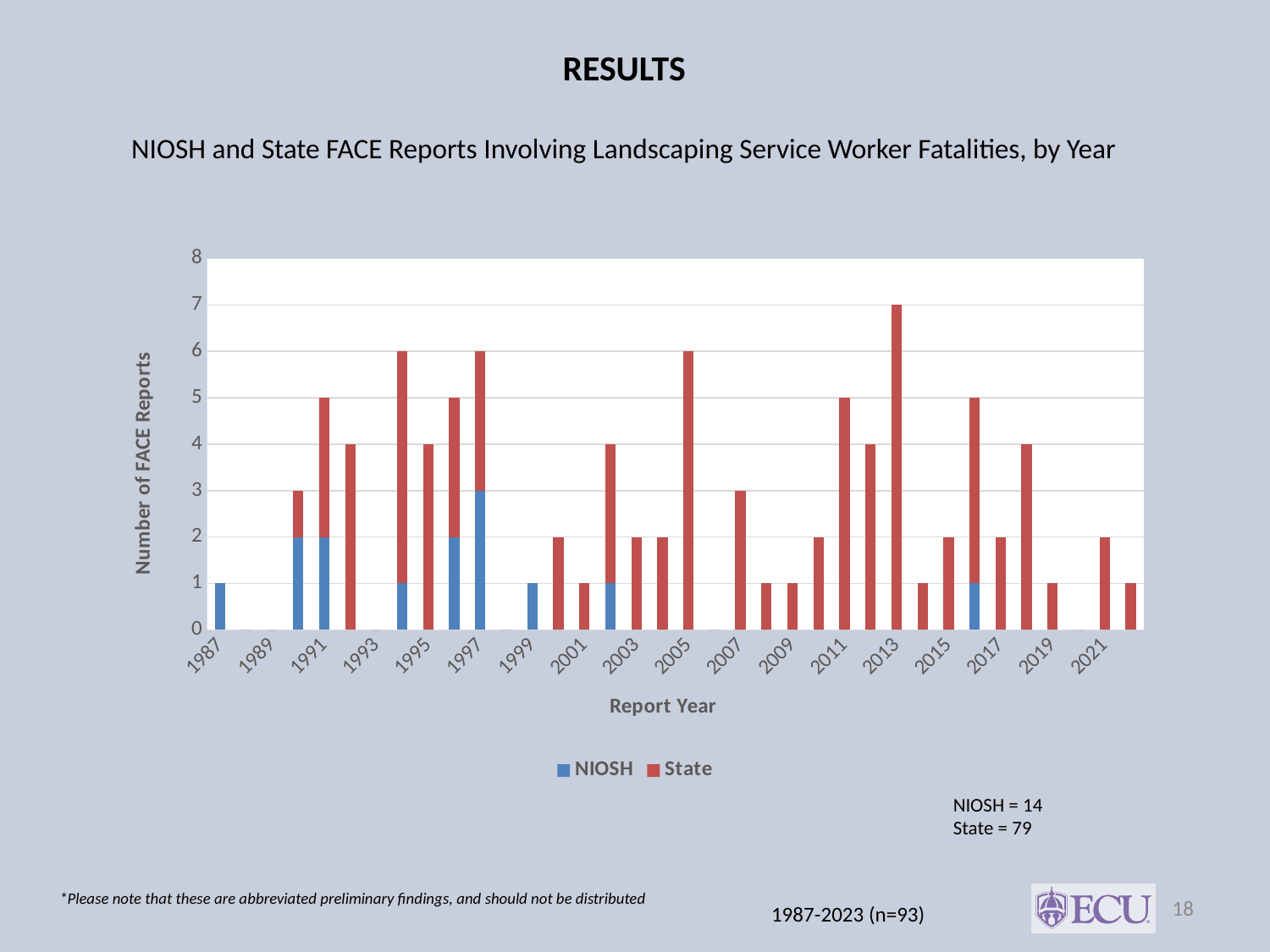
What is the difference between the total FACE reports in 2013 and in 2005? 1 What is the title of the y-axis? Number of FACE Reports Which report year has the highest total number of FACE reports? 2013 What kind of chart is shown on the slide? bar chart How many FACE reports are shown for 1987? 1 How many NIOSH reports are shown for 1997? 3 What is the number of FACE reports for 2005? 6 How many series does the legend list? 2 What is the total number of FACE reports for 2013? 7 What colour represents the NIOSH series in the chart? blue What is the total number of FACE reports for 1991? 5 Which year has more FACE reports, 2011 or 2007? 2011